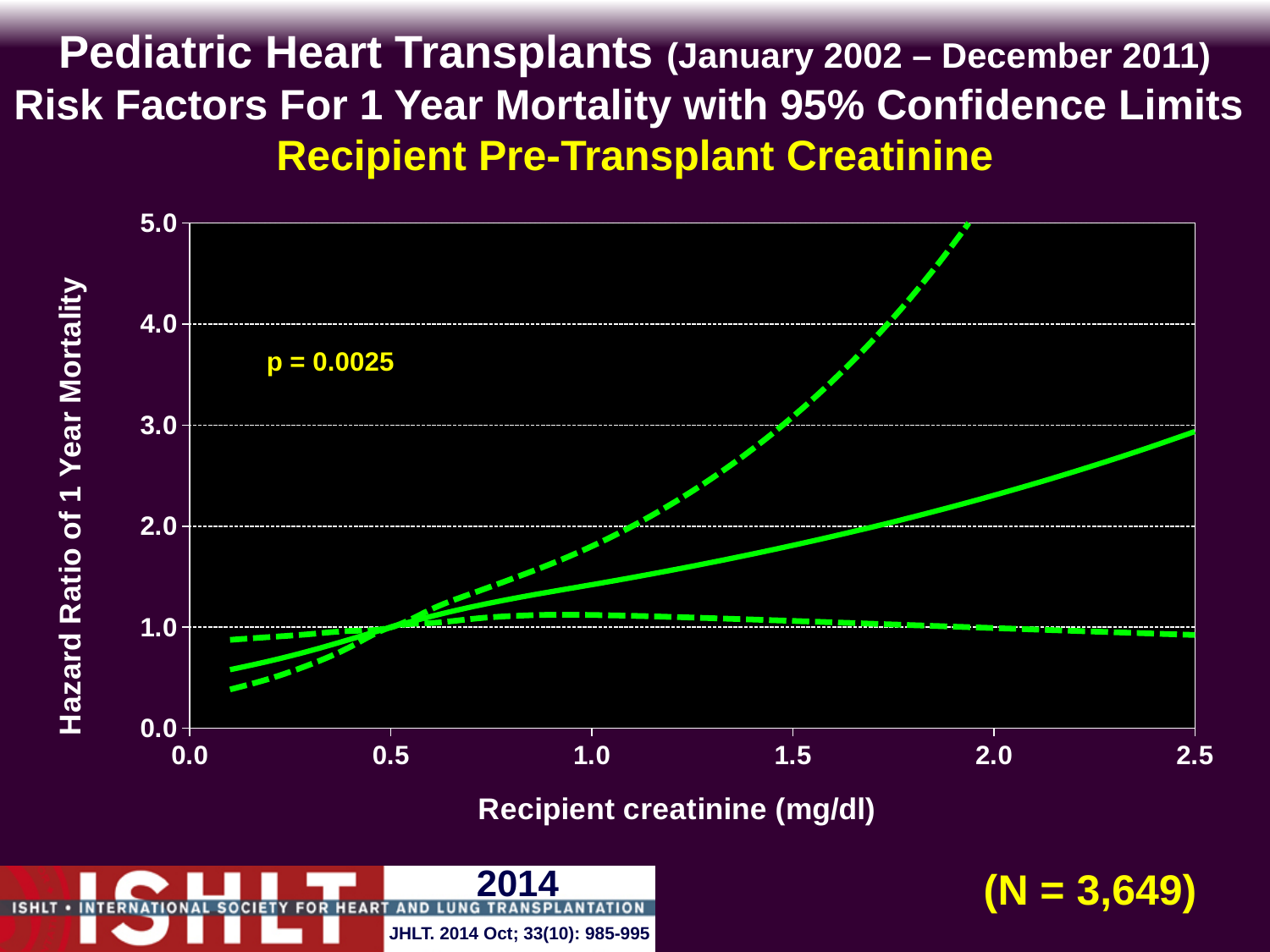
How many lines are plotted on the chart? 3 Is the hazard ratio on the solid line at a recipient creatinine of 2.5 mg/dl greater or less than 2.0? greater Is the lower 95% confidence limit (lower dashed line) at a recipient creatinine of 2.5 mg/dl greater or less than 1.0? less Is the upper 95% confidence limit (upper dashed line) at a recipient creatinine of 1.0 mg/dl greater or less than 2.0? less What is the label of the x axis? Recipient creatinine (mg/dl) What is the sample size (N) shown on the slide? N = 3,649 What kind of chart is shown on the slide? line chart What is the p-value shown on the chart? p = 0.0025 Does the hazard ratio of 1 year mortality (solid line) rise or fall as recipient creatinine increases? rise What is the maximum value shown on the y axis? 5.0